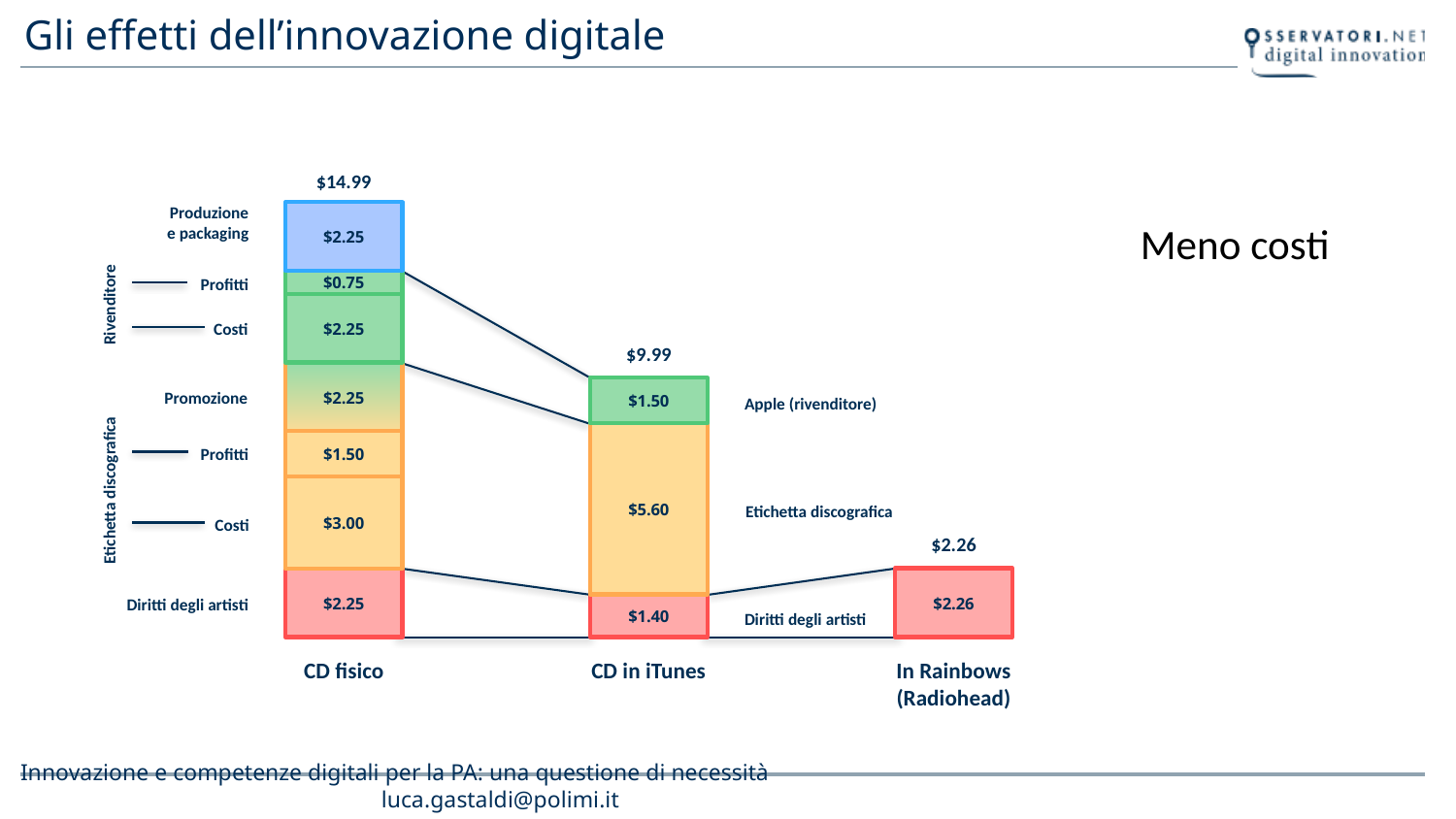
Which of the three bars has the highest total price? CD fisico What is the Costi value of the Etichetta discografica for CD fisico? $3.00 How many bars (categories) are shown in the chart? 3 Which of the three bars has the lowest total price? In Rainbows (Radiohead) What total price is printed above the CD in iTunes bar? $9.99 What is the Apple (rivenditore) value for CD in iTunes? $1.50 Do the total prices rise or fall from CD fisico to In Rainbows (Radiohead)? fall What is the Etichetta discografica value for CD in iTunes? $5.60 What is the difference between the Diritti degli artisti value for CD fisico and for CD in iTunes? $0.85 What is the Diritti degli artisti value for CD in iTunes? $1.40 What total price is printed above the CD fisico bar? $14.99 What value is shown for In Rainbows (Radiohead)? $2.26